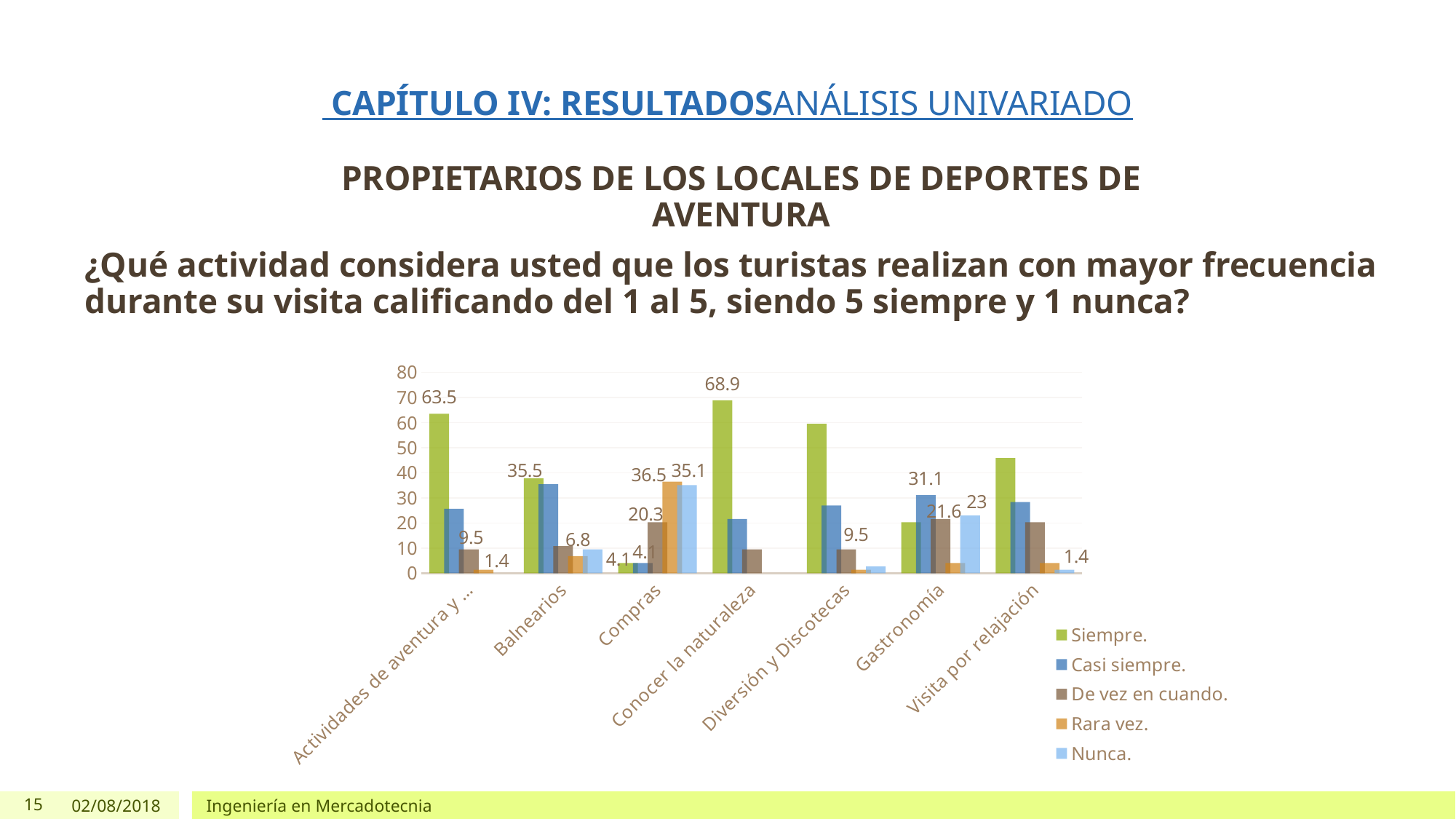
Which category has the highest value in the 'Siempre.' series? Conocer la naturaleza What is the difference between the 'Siempre.' values for 'Conocer la naturaleza' and 'Actividades de aventura y ...'? 5.4 For 'Compras', which is larger: the 'Rara vez.' value or the 'Nunca.' value? Rara vez. Is the 'Siempre.' value for 'Diversión y Discotecas' greater or less than 50? greater How many series does the legend list? 5 What is the value of the 'Nunca.' series for 'Gastronomía'? 23 What is the value of the 'Rara vez.' series for 'Compras'? 36.5 What is the value of the 'Siempre.' series for 'Conocer la naturaleza'? 68.9 What is the value of the 'Siempre.' series for 'Actividades de aventura y ...'? 63.5 How many categories are shown on the x axis of the chart? 7 What is the value of the 'Casi siempre.' series for 'Gastronomía'? 31.1 Which category has the lowest value in the 'Siempre.' series? Compras